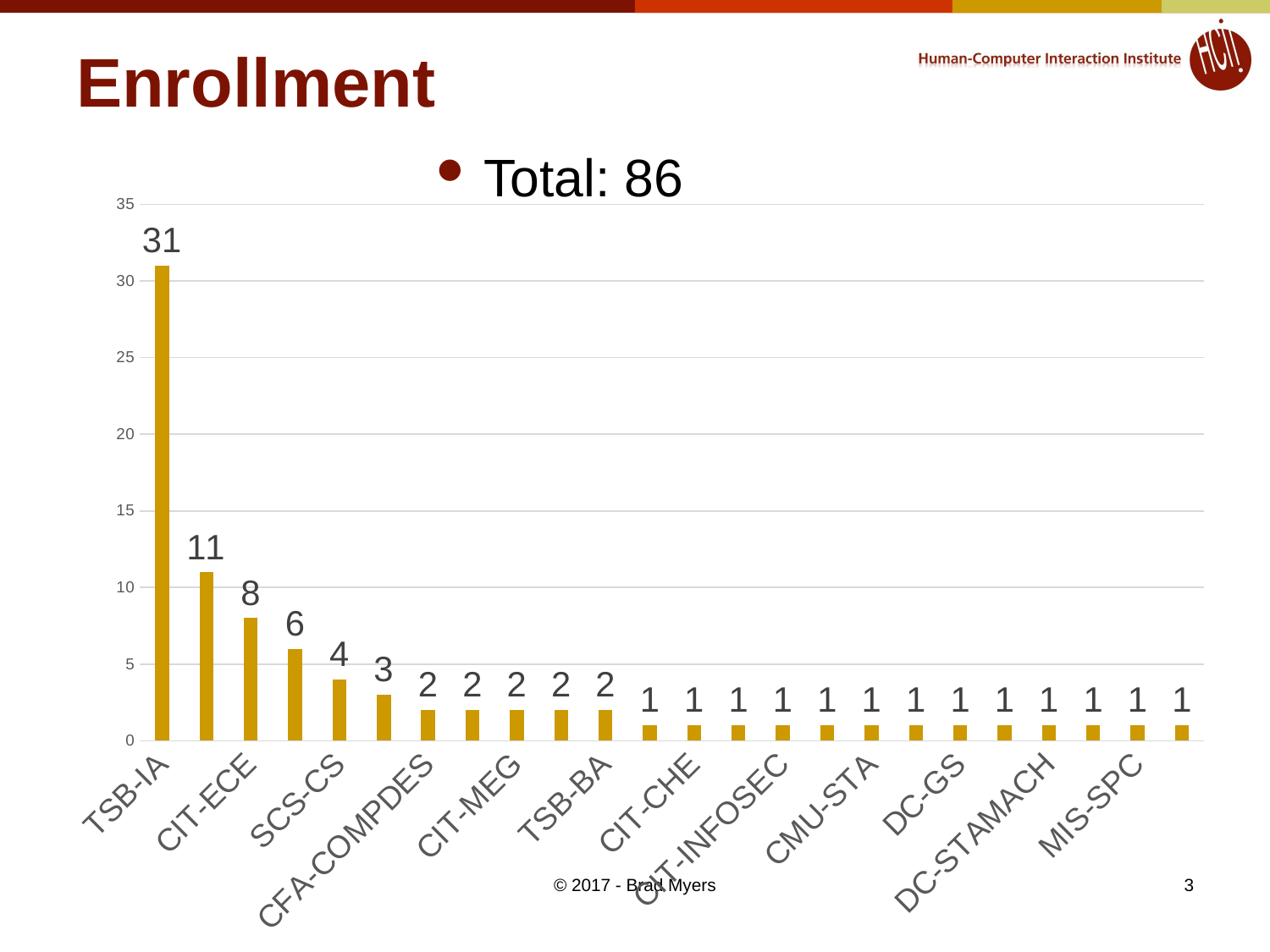
What is the value for CIT-ECE? 8 What total enrollment is stated on the slide above the chart? 86 How many bars are plotted in the chart? 24 What type of chart is shown on the slide? bar chart What is the difference between the values for TSB-IA and CIT-ECE? 23 What is the value for TSB-IA? 31 Do the values rise or fall from left to right along the x axis? fall What is the value for SCS-CS? 4 What is the value for CIT-CHE? 1 Which is larger, the value for CIT-ECE or the value for SCS-CS? CIT-ECE Which category has the highest value? TSB-IA Is the value for TSB-IA greater or less than 30? greater